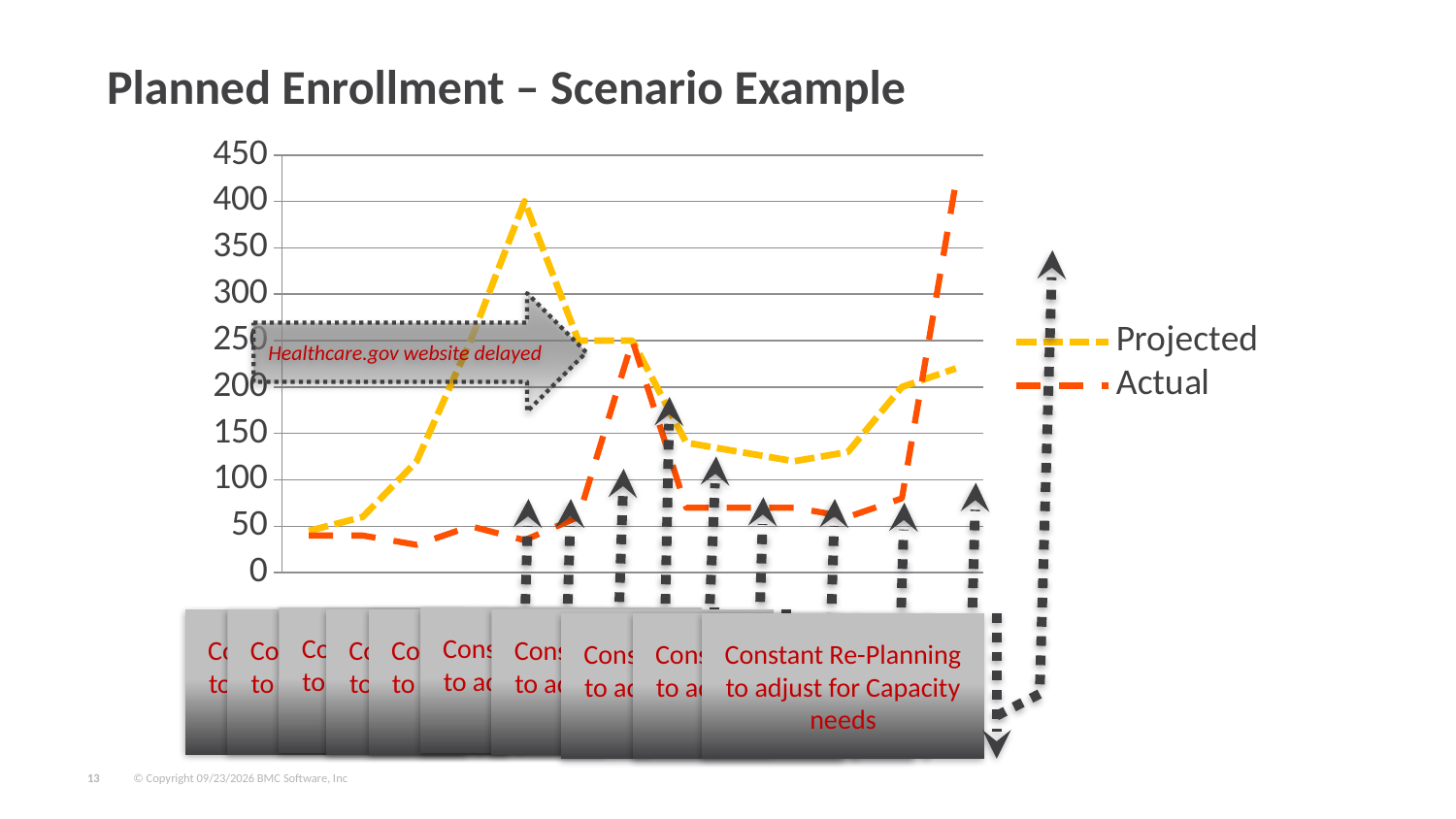
Is the first value of the Actual series greater or less than 100? less What is the highest value shown on the vertical axis? 450 How many series does the legend list? 2 What are the two series named in the legend? Projected and Actual Does the Actual series rise or fall over its final few points? rise At the right end of the chart, which series has the higher value, Projected or Actual? Actual Is the last value of the Actual series greater or less than 350? greater Is the last value of the Projected series greater or less than 300? less What kind of chart is shown on the slide? line chart What is the title of the slide containing the chart? Planned Enrollment – Scenario Example